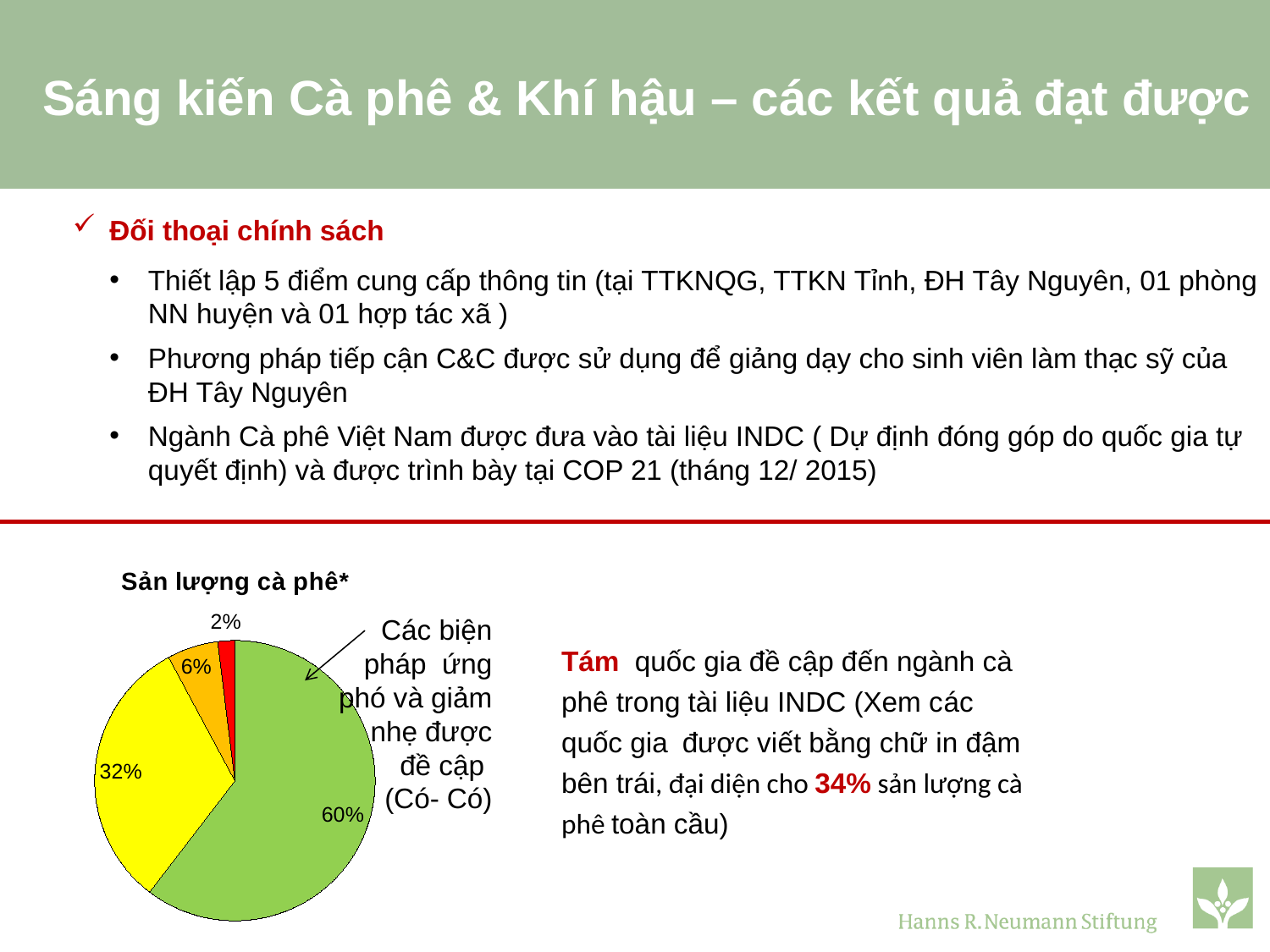
What is the difference between the largest slice (60%) and the second-largest slice (32%) in the pie chart? 28% What kind of chart is shown on the slide? pie chart What is the title of the chart on the slide? Sản lượng cà phê* Which is larger in the pie chart: the yellow slice or the orange slice? the yellow slice (32%) What is the share of the smallest slice in the pie chart? 2% What colour is the 60% slice in the pie chart? green What is the difference between the 6% slice and the 2% slice in the pie chart? 4% What is the share of the largest slice in the pie chart? 60% How many slices does the pie chart have? 4 What is the share of the yellow slice in the pie chart? 32% What share of the pie is labelled 'Các biện pháp ứng phó và giảm nhẹ được đề cập (Có- Có)'? 60% What is the combined share of the three slices other than the 60% slice? 40%